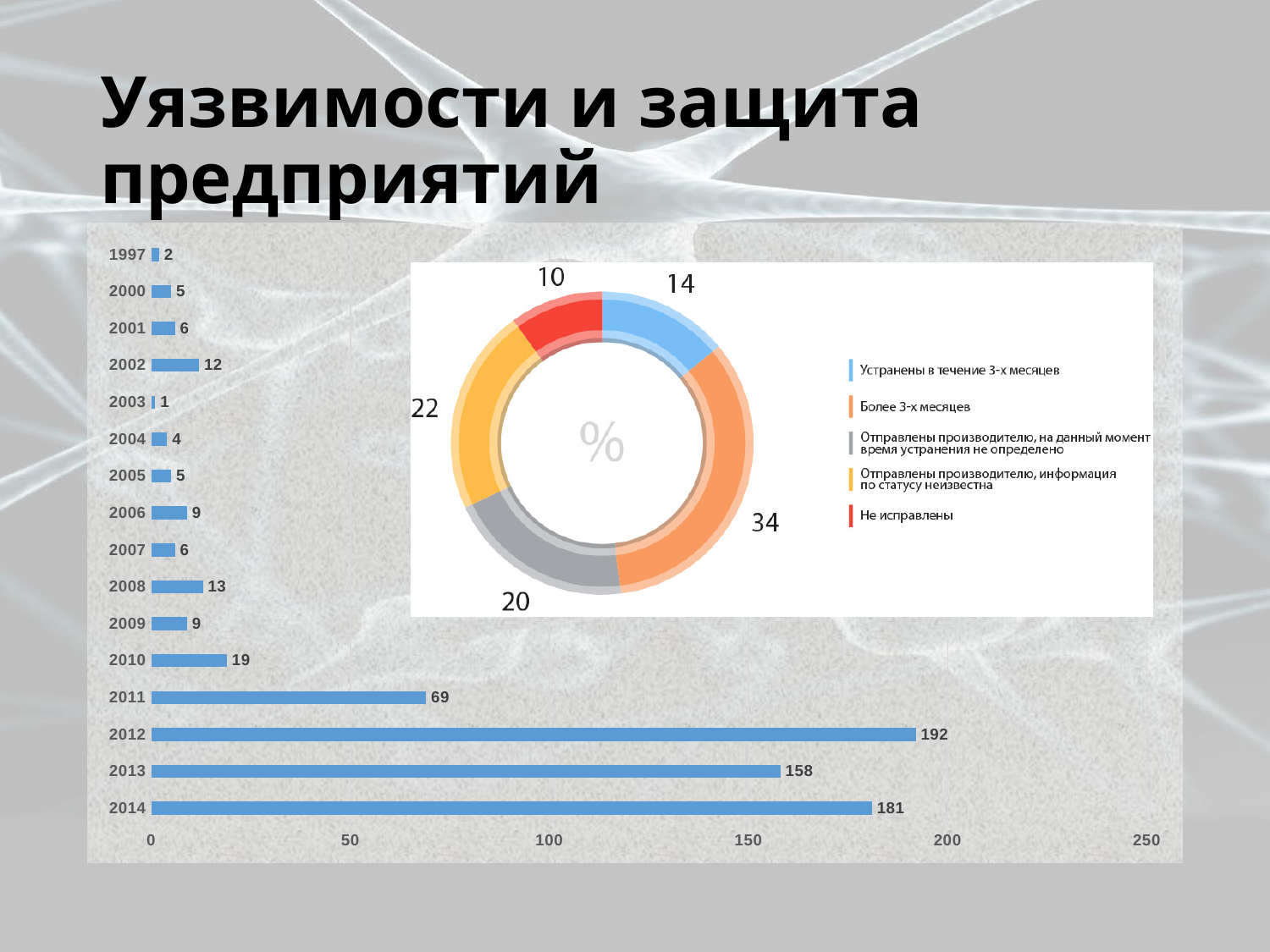
In the donut chart on the right, which segment has the smallest share? Не исправлены How many entries does the legend of the donut chart on the right list? 5 In the donut chart on the right, what percentage is shown for the segment 'Более 3-х месяцев'? 34 In the bar chart on the left, which is larger, the value for 2013 or the value for 2014? 2014 In the bar chart on the left, which year has the highest value? 2012 In the bar chart on the left, which year has the lowest value? 2003 In the bar chart on the left, what is the value for 2011? 69 How many years are shown in the bar chart on the left? 16 In the bar chart on the left, is the value for 2014 greater or less than 150? greater In the bar chart on the left, what is the value for 2012? 192 What kind of chart is the chart on the left of the slide? bar chart In the bar chart on the left, what is the difference between the values for 2012 and 2013? 34